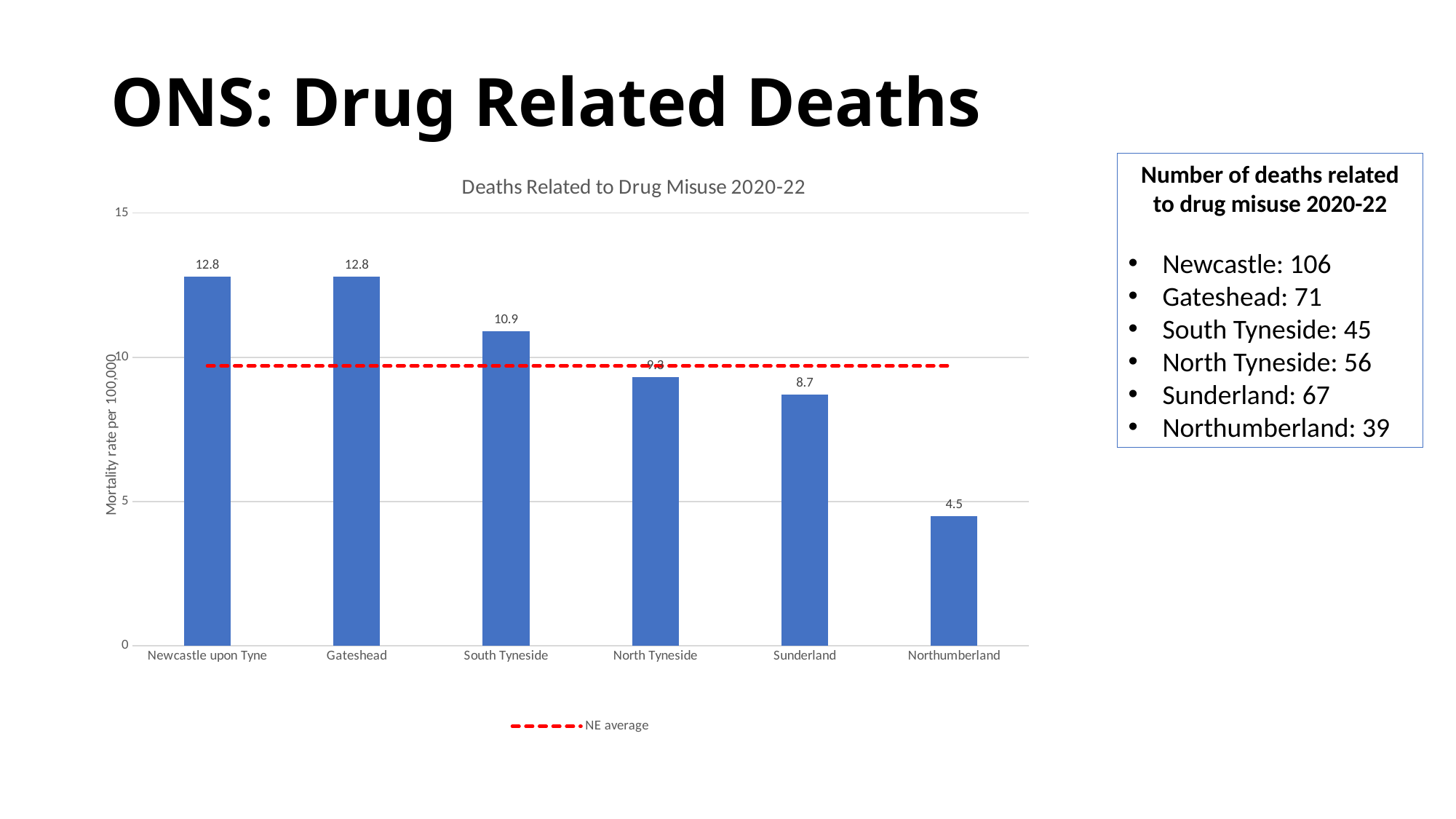
What is the difference between the values for South Tyneside and Northumberland in the Deaths Related to Drug Misuse 2020-22 chart? 6.4 What kind of chart is the Deaths Related to Drug Misuse 2020-22 chart? combination bar and line chart Which category has the lowest value in the Deaths Related to Drug Misuse 2020-22 chart? Northumberland How many categories are shown on the x axis of the Deaths Related to Drug Misuse 2020-22 chart? 6 What does the red dashed line in the Deaths Related to Drug Misuse 2020-22 chart represent, according to the legend? NE average Is the value for North Tyneside in the Deaths Related to Drug Misuse 2020-22 chart greater or less than 10? less Which has a higher value in the Deaths Related to Drug Misuse 2020-22 chart, South Tyneside or Sunderland? South Tyneside What is the value for Northumberland in the Deaths Related to Drug Misuse 2020-22 chart? 4.5 Do the bar values rise or fall from left to right in the Deaths Related to Drug Misuse 2020-22 chart? fall What is the value for South Tyneside in the Deaths Related to Drug Misuse 2020-22 chart? 10.9 What is the value for Sunderland in the Deaths Related to Drug Misuse 2020-22 chart? 8.7 What is the value for Newcastle upon Tyne in the Deaths Related to Drug Misuse 2020-22 chart? 12.8